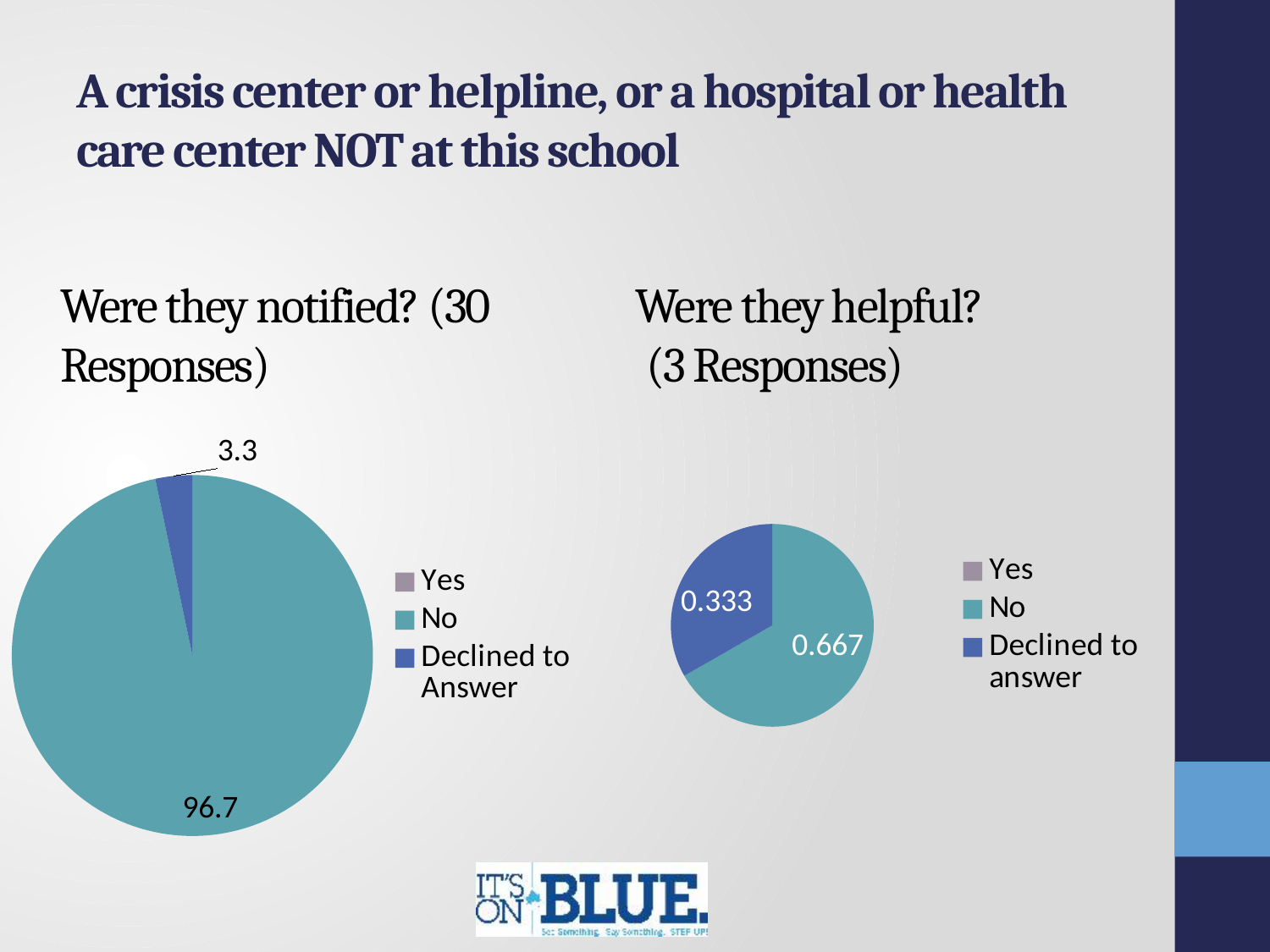
How many responses does the 'Were they notified?' chart title say it is based on? 30 In the 'Were they notified?' chart, what value is shown for No? 96.7 In the 'Were they helpful?' chart, what value is shown for No? 0.667 What type of chart is used for 'Were they notified?'? Pie chart In the 'Were they helpful?' chart, which is larger, No or Declined to answer? No In the 'Were they notified?' chart, what is the difference between the No value and the Declined to Answer value? 93.4 In the 'Were they helpful?' chart, which category has the largest slice? No In the 'Were they helpful?' chart, what value is shown for Declined to answer? 0.333 How many entries does the legend of the 'Were they helpful?' chart list? 3 In the 'Were they helpful?' chart, what is the difference between the No value and the Declined to answer value? 0.334 In the 'Were they notified?' chart, which category has the largest slice? No In the 'Were they notified?' chart, what value is shown for Declined to Answer? 3.3